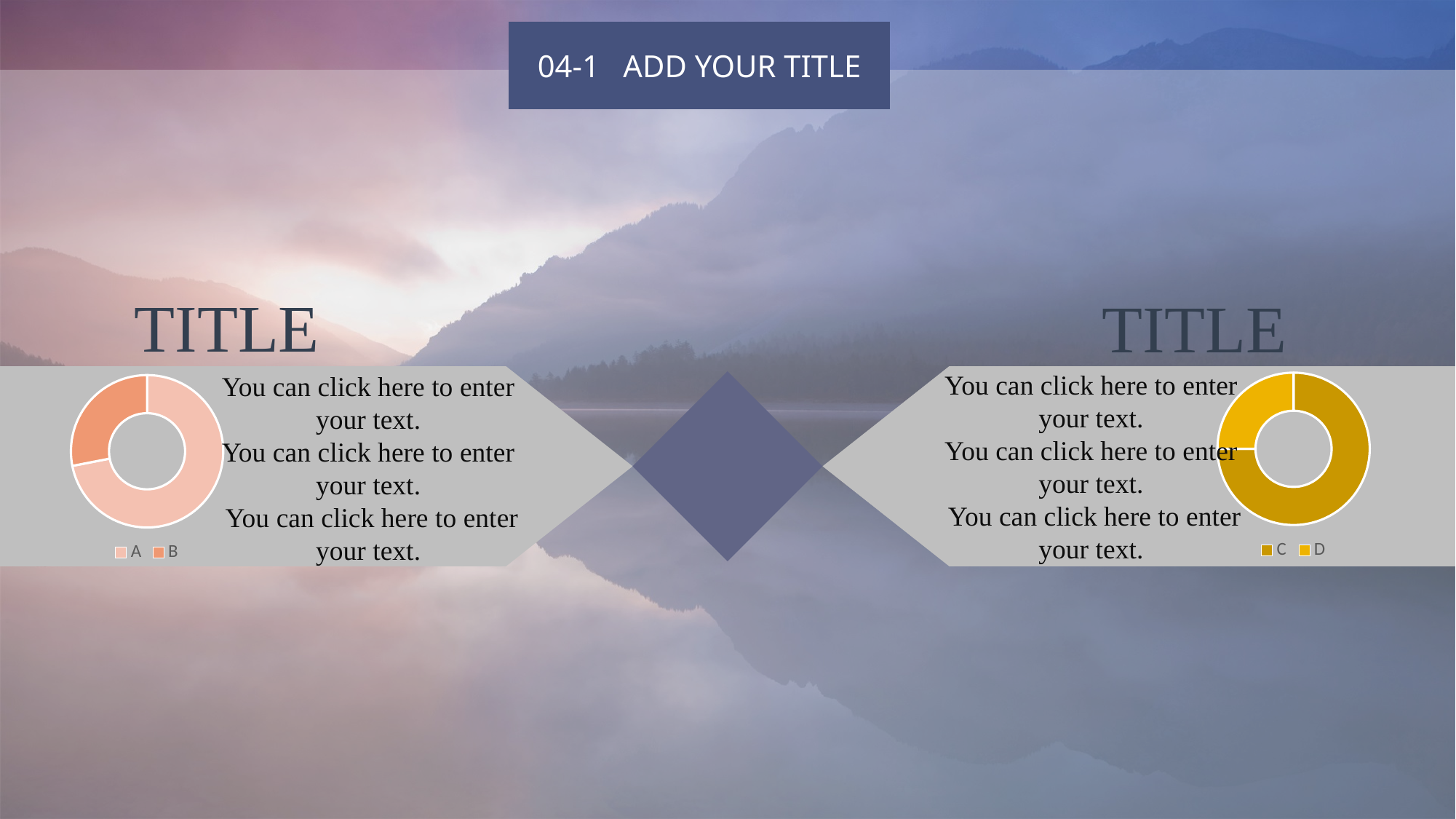
What kind of chart is the left chart on the slide? doughnut chart In the right chart, which category has the smallest slice? D In the left chart, which slice is larger, A or B? A In the right chart, which category has the largest slice? C How many categories does the legend of the right chart list? 2 What kind of chart is the right chart on the slide? doughnut chart In the left chart, which category has the largest slice? A How many charts are shown on the slide? 2 How many categories does the legend of the left chart list? 2 In the left chart, which category has the smallest slice? B What are the legend entries of the right chart? C and D In the right chart, which slice is larger, C or D? C